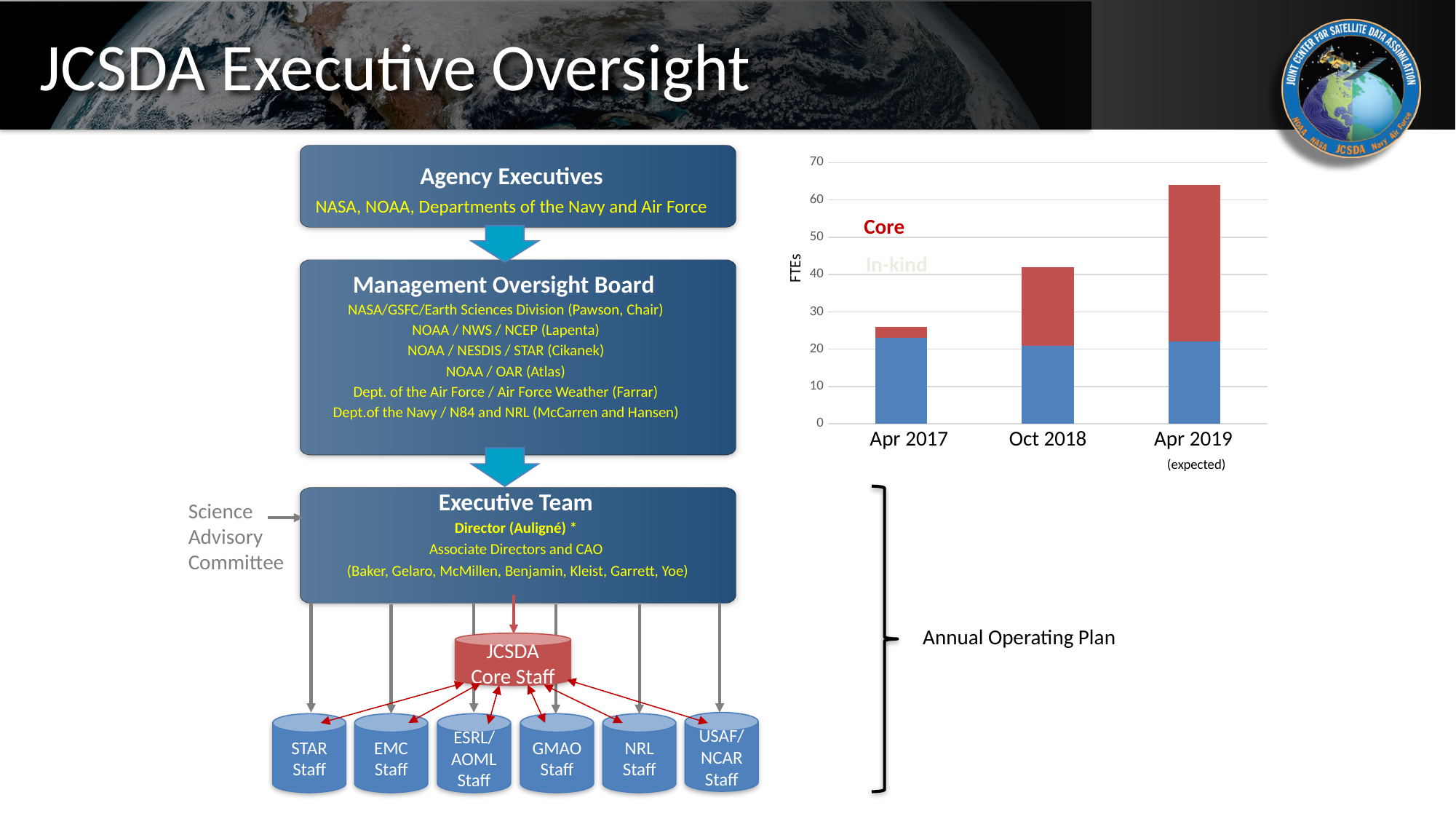
Which period has the highest total FTEs in the chart? Apr 2019 Do total FTEs rise or fall from Apr 2017 to Apr 2019 in the chart? rise How many series does the FTEs chart show? 2 In Apr 2019, which is larger: Core FTEs or In-kind FTEs? Core Is the total FTEs value for Apr 2019 greater or less than 60? greater Is the total FTEs value for Apr 2017 greater or less than 30? less What is the label on the vertical axis of the chart? FTEs Which period has the lowest total FTEs in the chart? Apr 2017 In Apr 2017, which is larger: Core FTEs or In-kind FTEs? In-kind How many time periods (bars) are shown in the FTEs chart? 3 Which series in the chart is shown in red? Core What kind of chart is shown on the right side of the slide? stacked bar chart